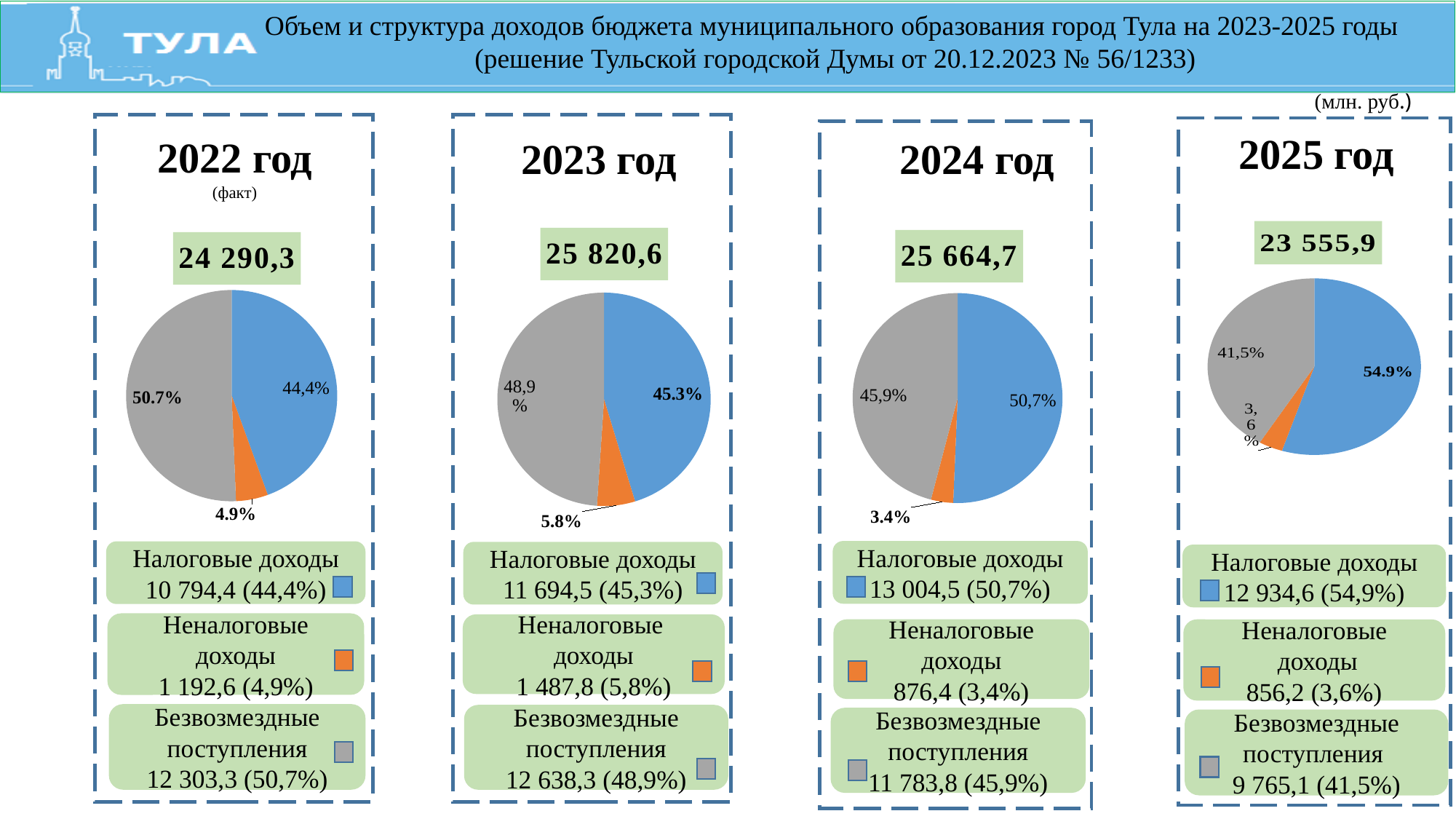
In the 2022 год pie chart, which is larger: Налоговые доходы or Безвозмездные поступления? Безвозмездные поступления In the 2025 год pie chart, which category has the largest slice? Налоговые доходы In the 2022 год pie chart, what share is shown for Безвозмездные поступления? 50,7% How many slices does each pie chart on the slide have? 3 In the 2025 год panel, what is the value of Неналоговые доходы in млн. руб.? 856,2 In the 2023 год pie chart, what share is shown for Налоговые доходы? 45,3% What is the total budget revenue shown above the 2023 год pie chart? 25 820,6 In the 2024 год pie chart, what share is shown for Неналоговые доходы? 3,4% In the 2023 год pie chart, which category has the smallest slice? Неналоговые доходы In the 2024 год panel, what is the value of Налоговые доходы in млн. руб.? 13 004,5 What kind of chart is used for the 2022 год panel? pie chart